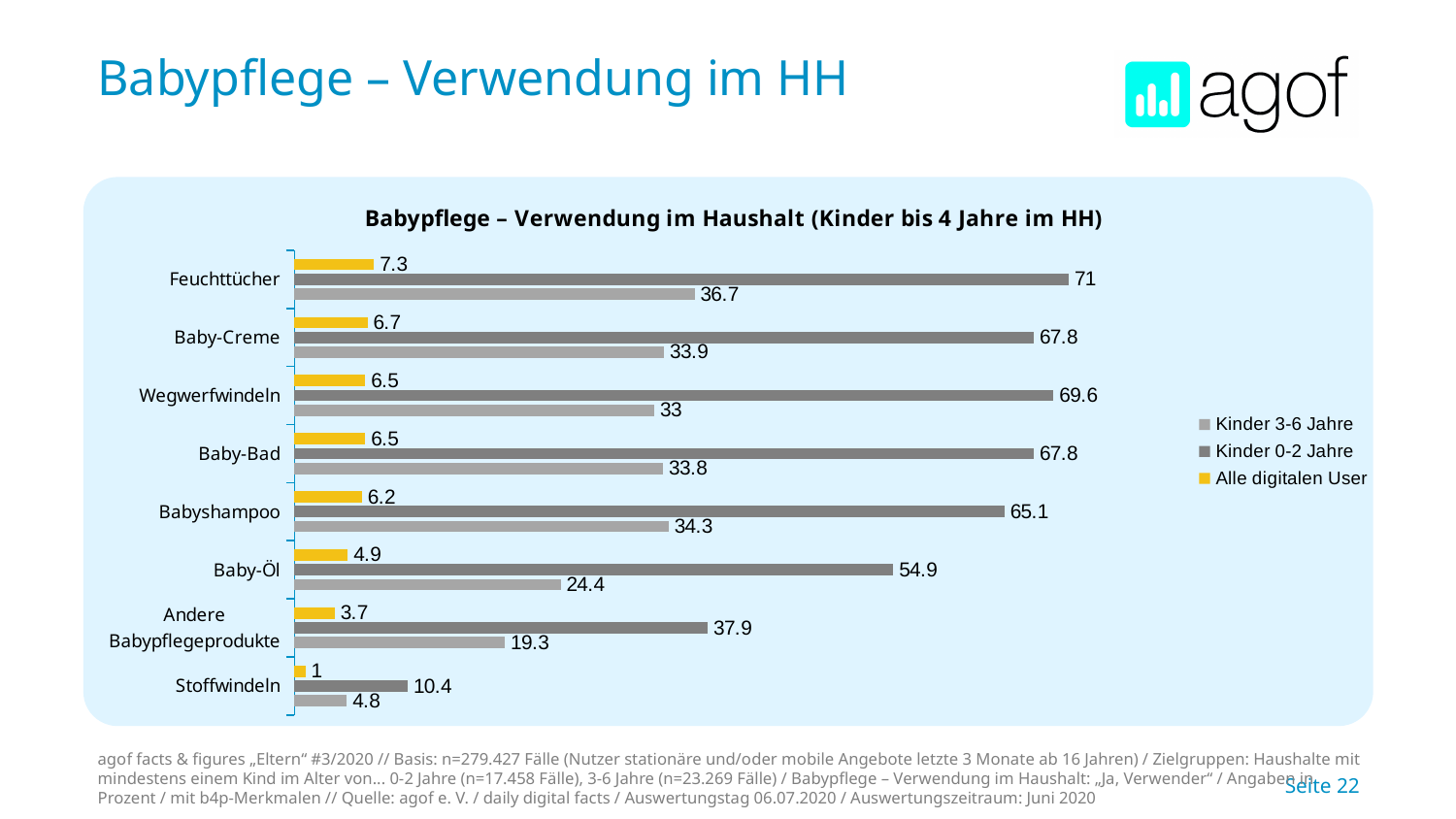
Which series is shown in yellow? Alle digitalen User What is the value for Stoffwindeln in the Alle digitalen User series? 1 What is the value for Baby-Öl in the Kinder 3-6 Jahre series? 24.4 What is the value for Feuchttücher in the Kinder 0-2 Jahre series? 71 What is the difference between the Kinder 0-2 Jahre and Kinder 3-6 Jahre values for Wegwerfwindeln? 36.6 What kind of chart is shown on the slide? Bar chart How many categories are shown on the chart? 8 What is the title of the chart? Babypflege – Verwendung im Haushalt (Kinder bis 4 Jahre im HH) Which is larger for Babyshampoo: the Kinder 0-2 Jahre value or the Kinder 3-6 Jahre value? Kinder 0-2 Jahre Which category has the lowest value in the Kinder 3-6 Jahre series? Stoffwindeln Which category has the highest value in the Kinder 0-2 Jahre series? Feuchttücher How many series does the legend list? 3